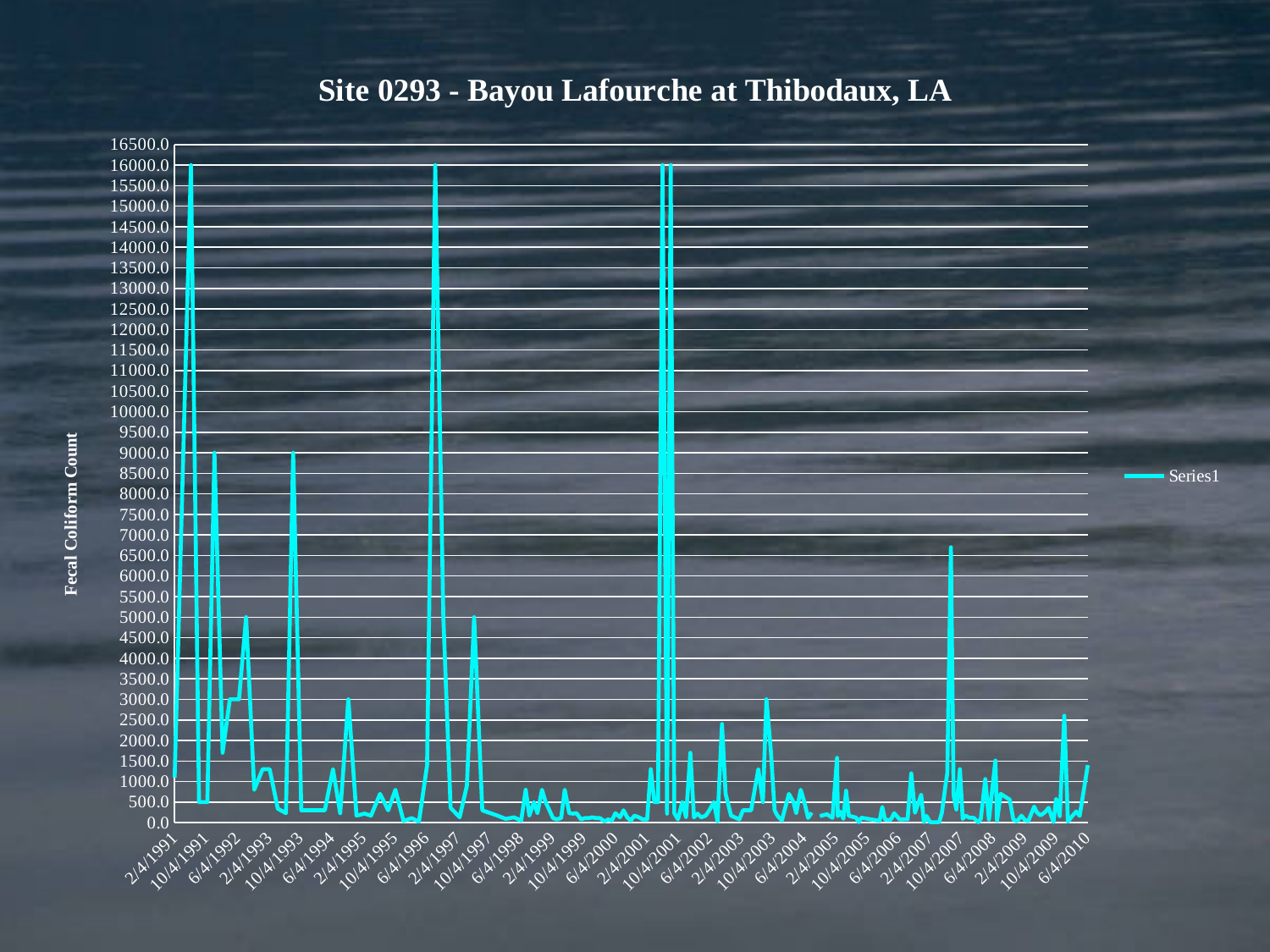
Is the peak value near 10/4/1997 greater or less than 4000? greater What kind of chart is shown on the slide? line chart What is the title of the chart? Site 0293 - Bayou Lafourche at Thibodaux, LA Is the peak value near 10/4/2007 greater or less than 6000? greater Which is larger: the peak near 10/4/1993 or the peak near 10/4/2007? the peak near 10/4/1993 How many series does the legend list? 1 Is the value at 6/4/2010 greater or less than 2000? less Which is larger: the peak near 6/4/1996 or the peak near 10/4/1997? the peak near 6/4/1996 What is the label on the vertical axis of the chart? Fecal Coliform Count